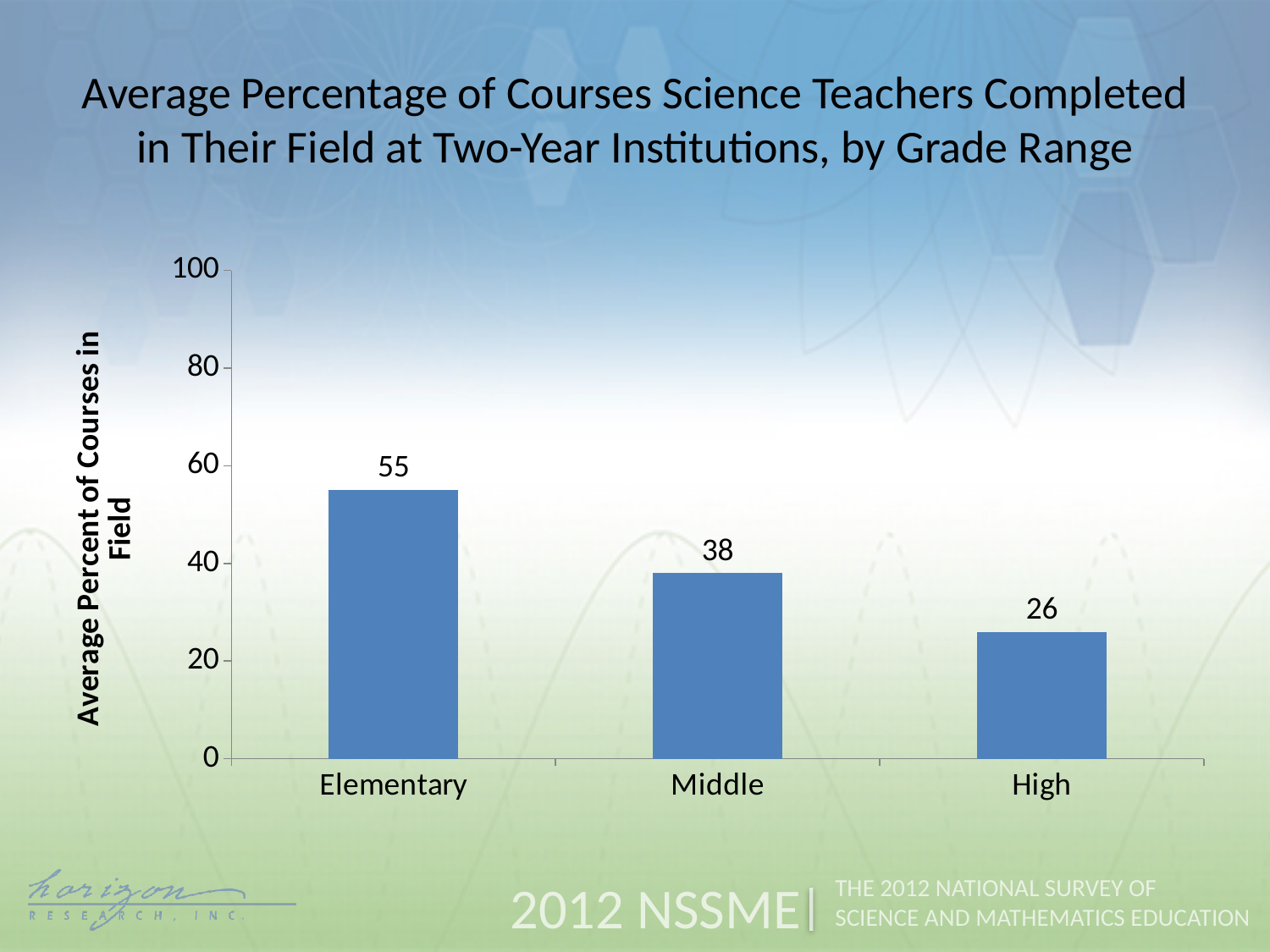
What is the difference between the values for Elementary and High? 29 What kind of chart is shown on the slide? bar chart Which grade range has the lowest average percent of courses in field? High Which grade range has the highest average percent of courses in field? Elementary What is the value for High? 26 Which is larger, the value for Middle or the value for High? Middle Is the value for Elementary greater or less than 60? less Do the values rise or fall from Elementary to High along the x axis? fall What is the value for Middle? 38 What is the difference between the values for Middle and High? 12 What is the value for Elementary? 55 How many grade ranges are shown on the chart? 3